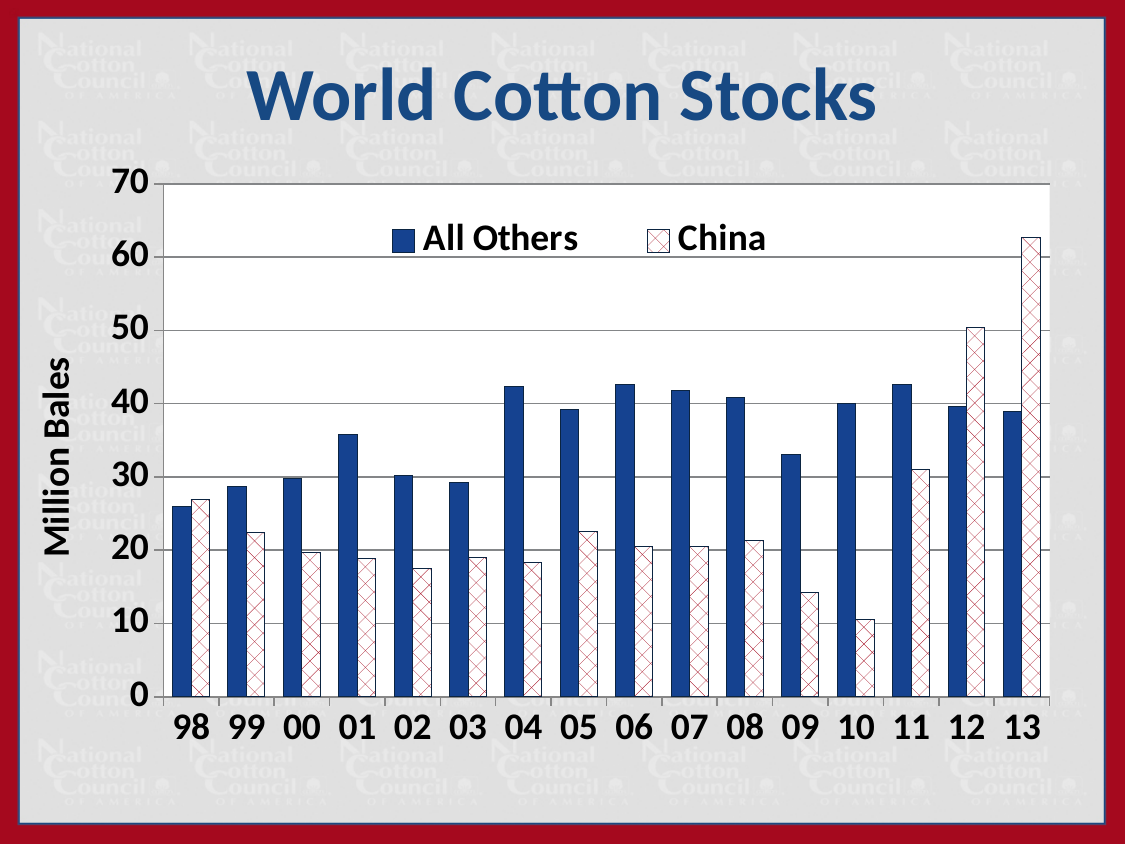
In which year is the All Others value lowest? 98 What kind of chart is shown on the slide? bar chart Do the China values rise or fall from 10 to 13? rise In 10, which series has the larger value, All Others or China? All Others How many series does the legend list? 2 Is the All Others value for 04 greater or less than 40? greater Is the China value for 10 greater or less than 20? less How many years are shown along the x axis? 16 In which year is the China value lowest? 10 Is the China value for 13 greater or less than 60? greater In 13, which series has the larger value, All Others or China? China In which year is the China value highest? 13